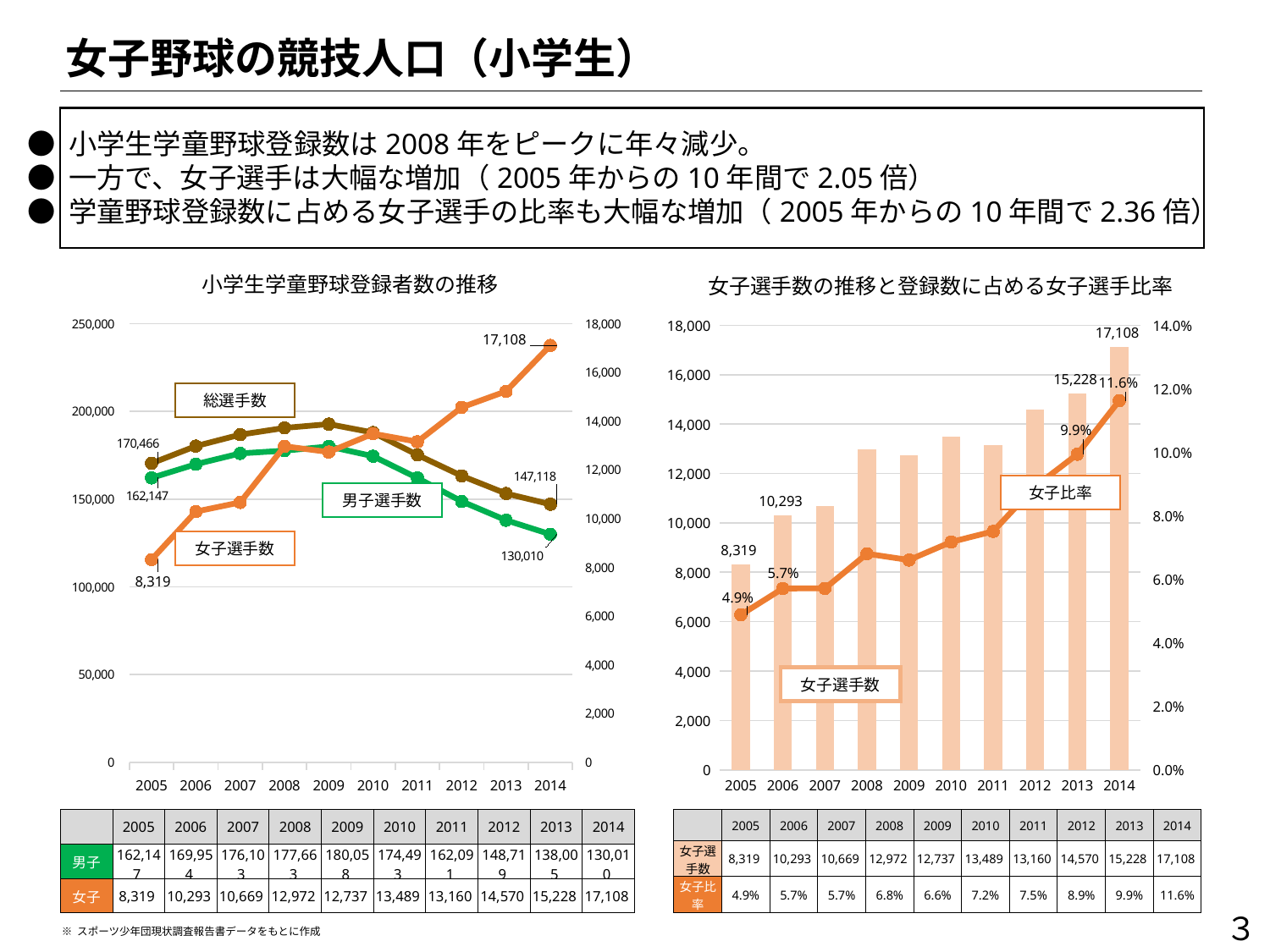
In the chart titled 小学生学童野球登録者数の推移, what is the value of 総選手数 in 2014? 147,118 In the chart titled 女子選手数の推移と登録数に占める女子選手比率, what is the 女子選手数 in 2006? 10,293 In the chart titled 女子選手数の推移と登録数に占める女子選手比率, what is the 女子比率 in 2013? 9.9% In the chart titled 小学生学童野球登録者数の推移, does 男子選手数 rise or fall from 2009 to 2014? fall In the chart titled 女子選手数の推移と登録数に占める女子選手比率, in which year is 女子比率 lowest? 2005 In the chart titled 小学生学童野球登録者数の推移, what is the difference between 男子選手数 in 2005 and in 2014? 32,137 In the chart titled 小学生学童野球登録者数の推移, what is the value of 男子選手数 in 2005? 162,147 In the chart titled 女子選手数の推移と登録数に占める女子選手比率, is the 女子選手数 bar for 2011 greater or less than 12,000? greater In the chart titled 小学生学童野球登録者数の推移, in which year is 男子選手数 highest? 2009 In the chart titled 女子選手数の推移と登録数に占める女子選手比率, what kind of chart is used to show 女子選手数? bar chart In the chart titled 小学生学童野球登録者数の推移, how many years are shown on the x axis? 10 In the chart titled 小学生学童野球登録者数の推移, what is the value of 女子選手数 in 2014? 17,108